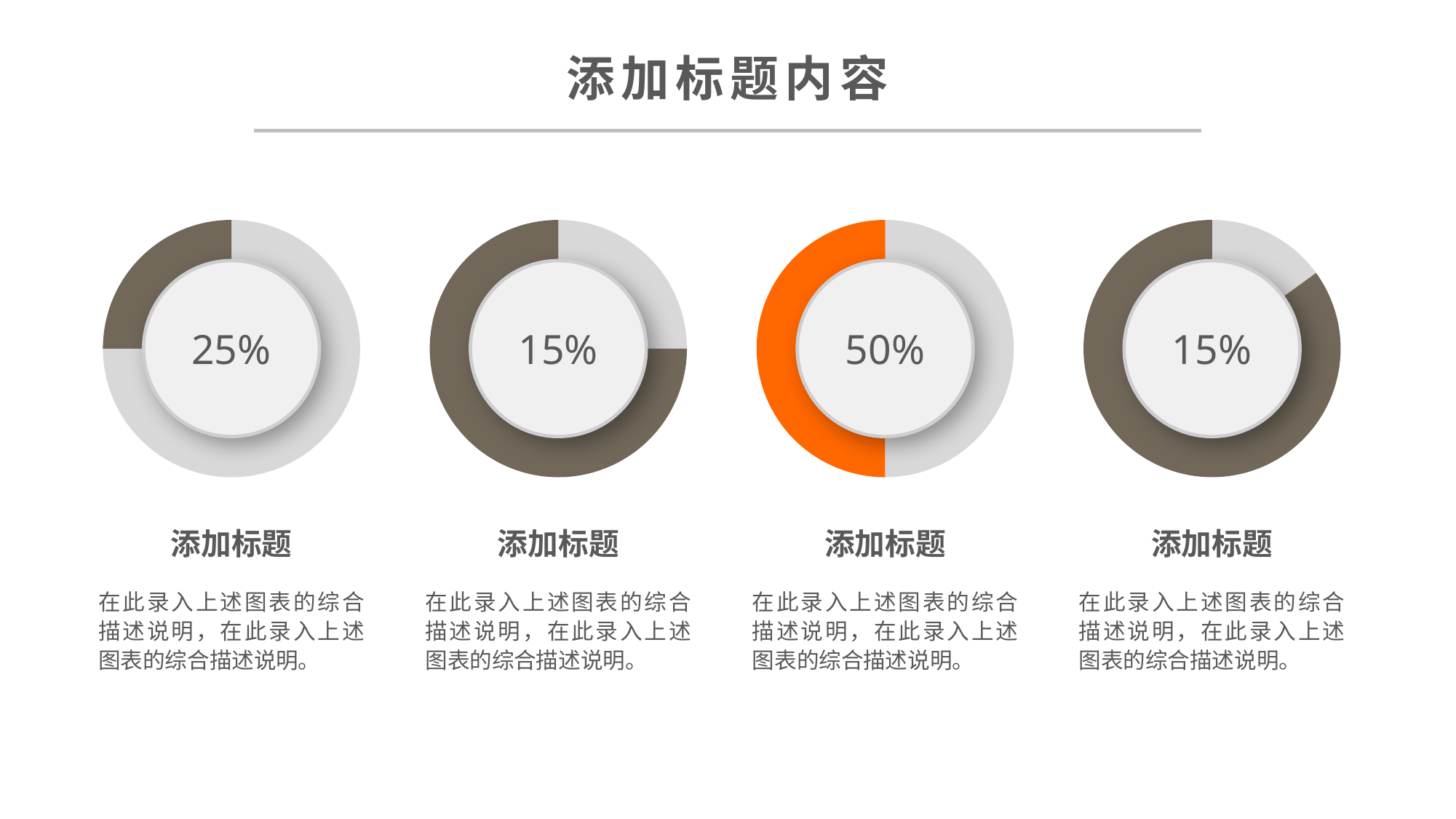
What percentage is shown in the centre of the third donut chart from the left? 50% What is the title of the slide? 添加标题内容 Which donut chart shows the highest percentage? The third from the left (50%) What percentage is shown in the centre of the fourth (rightmost) donut chart? 15% How many donut charts are on the slide? 4 Which shows a larger percentage, the first donut chart or the third donut chart? The third donut chart What kind of chart is used on this slide? Donut (ring) chart What is the lowest percentage shown among the four donut charts? 15% What percentage is shown in the centre of the second donut chart from the left? 15% What is the difference between the percentage in the third donut chart and the percentage in the first donut chart? 25 percentage points Which donut chart uses an orange fill instead of brown? The third from the left (50%) What percentage is shown in the centre of the first (leftmost) donut chart? 25%